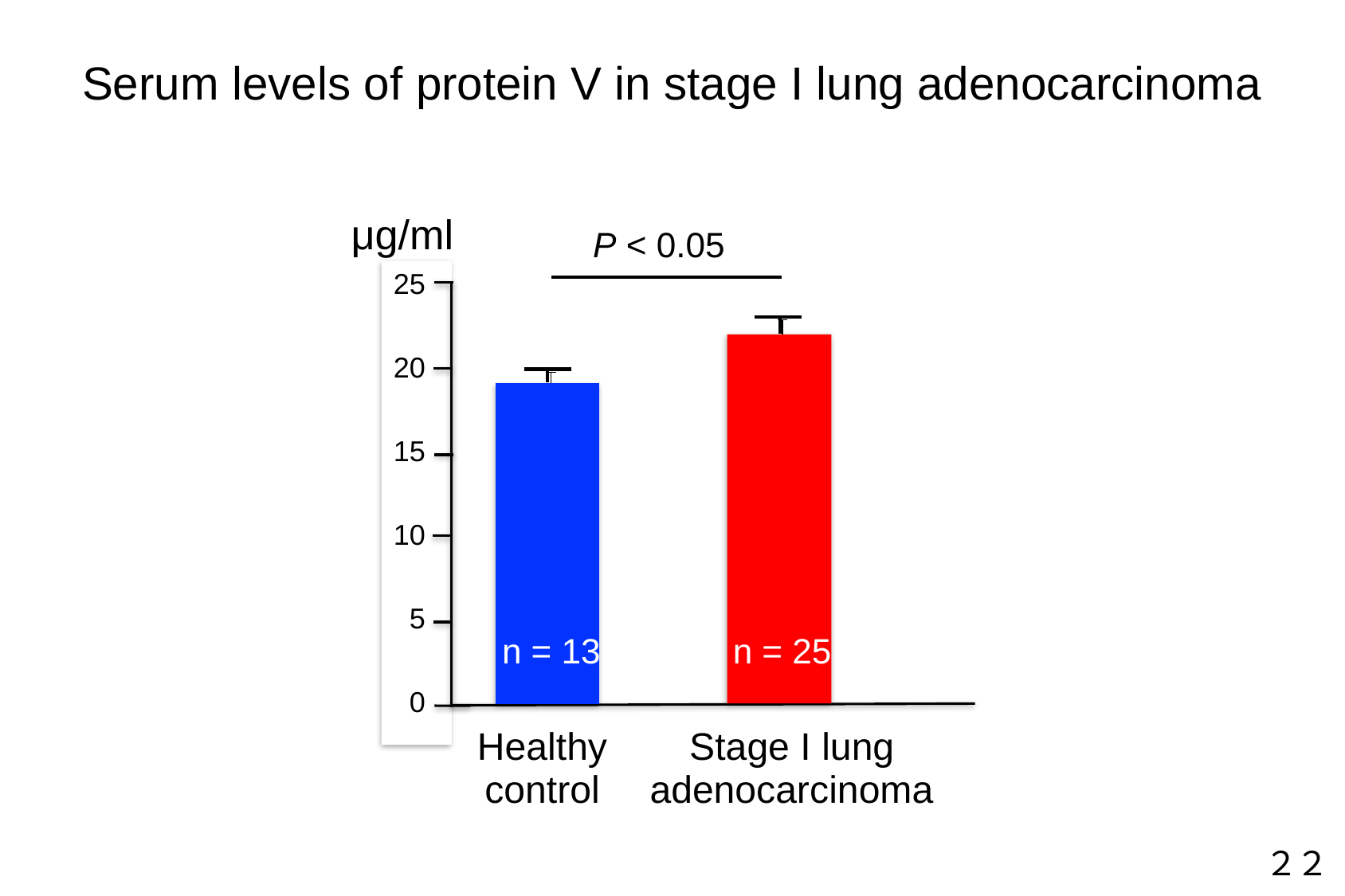
What is the sample size (n) printed on the Healthy control bar? n = 13 Which is larger, the value for Healthy control or the value for Stage I lung adenocarcinoma? Stage I lung adenocarcinoma Is the value for Stage I lung adenocarcinoma greater or less than 25? less How many categories (bars) are shown in the chart? 2 What unit is shown on the y axis of the chart? µg/ml What colour is the bar for Stage I lung adenocarcinoma? Red Is the value for Healthy control greater or less than 20? less Is the value for Stage I lung adenocarcinoma greater or less than 20? greater What kind of chart is shown on the slide? Bar chart What is the sample size (n) printed on the Stage I lung adenocarcinoma bar? n = 25 Which category has the highest serum level of protein V? Stage I lung adenocarcinoma Which category has the lowest serum level of protein V? Healthy control